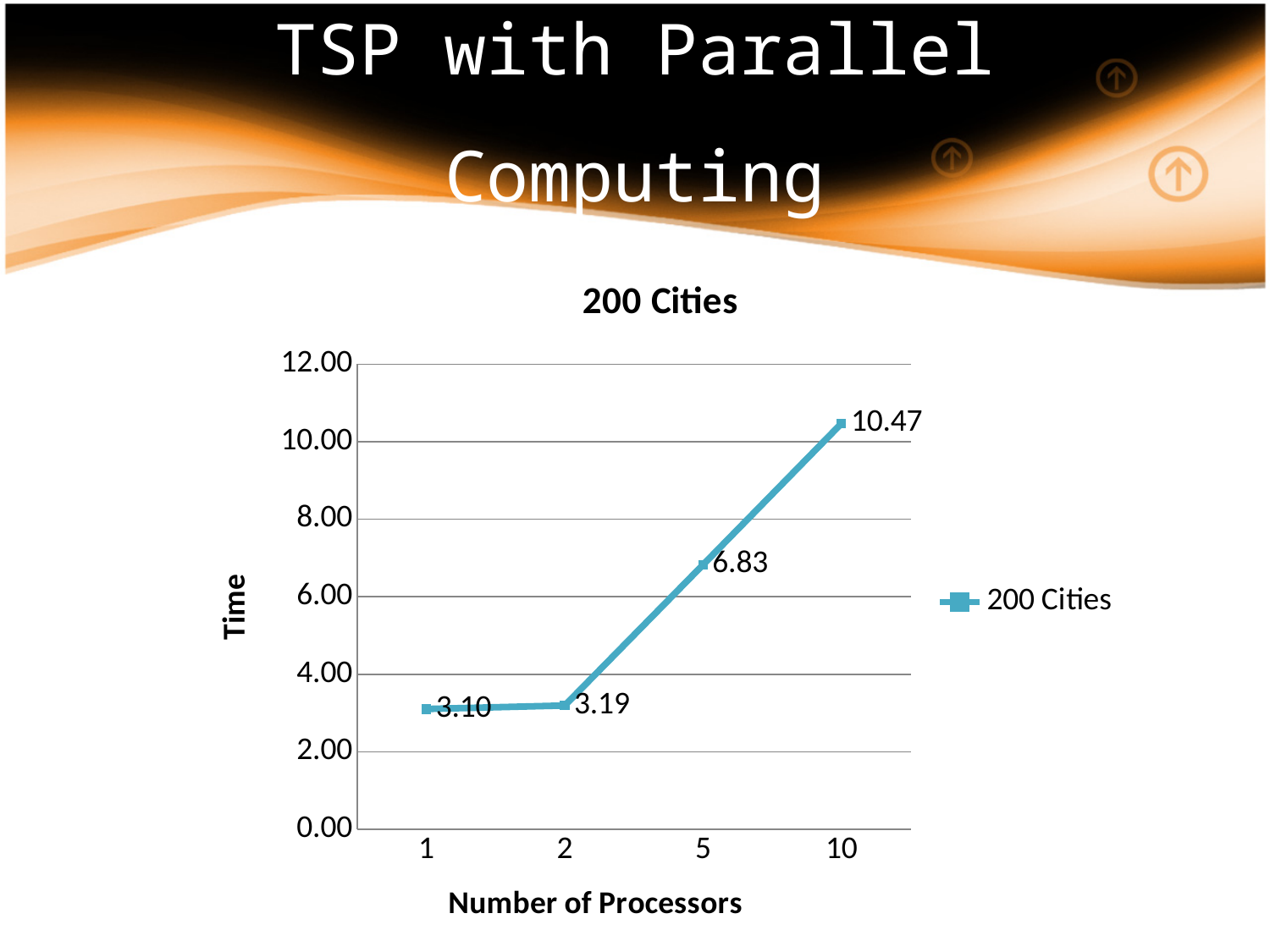
What is the Time value for 5 processors? 6.83 Does the Time value rise or fall as the number of processors increases? rise Which number of processors has the highest Time value? 10 What is the Time value for 10 processors? 10.47 Is the Time value for 10 processors greater or less than 10.00? greater Which has a larger Time value: 5 processors or 2 processors? 5 processors Which number of processors has the lowest Time value? 1 What is the difference in Time between 10 processors and 5 processors? 3.64 What kind of chart is shown on the slide? line chart How many data points are plotted on the chart? 4 What is the Time value for 1 processor? 3.10 What is the Time value for 2 processors? 3.19